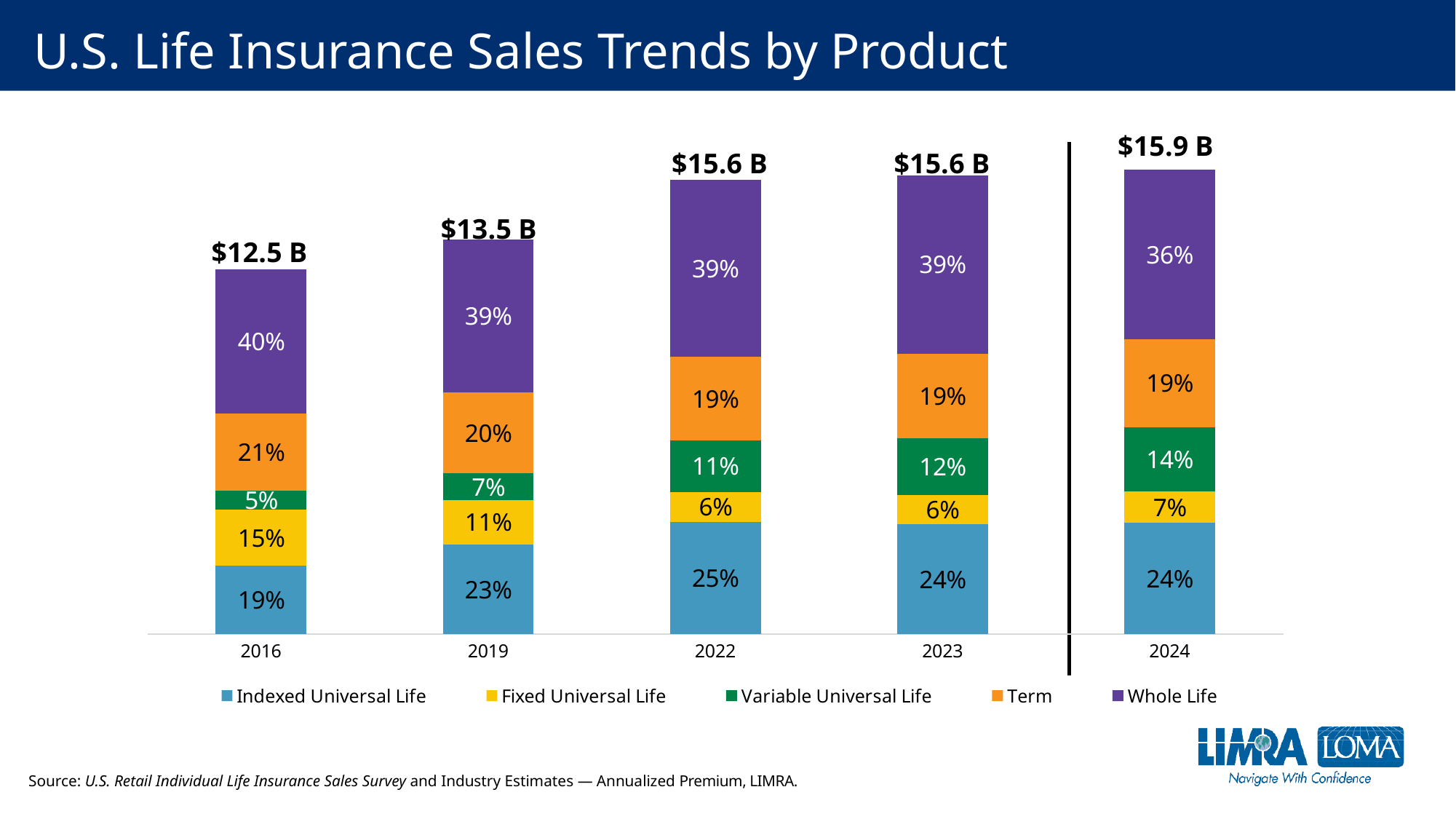
What kind of chart is shown on the slide? Stacked bar chart Which is larger, the Term share in 2016 or the Term share in 2024? Term share in 2016 What share of sales did Variable Universal Life account for in 2019? 7% How many series does the legend list? 5 What is the difference in total annualized premium between 2024 and 2016? $3.4 B What share of sales did Whole Life account for in 2016? 40% What was the total annualized premium shown above the 2024 bar? $15.9 B Which colour represents Whole Life in the chart? Purple Which year has the lowest total annualized premium? 2016 How many years are shown on the x axis? 5 What share of sales did Indexed Universal Life account for in 2022? 25% Which year has the highest total annualized premium? 2024